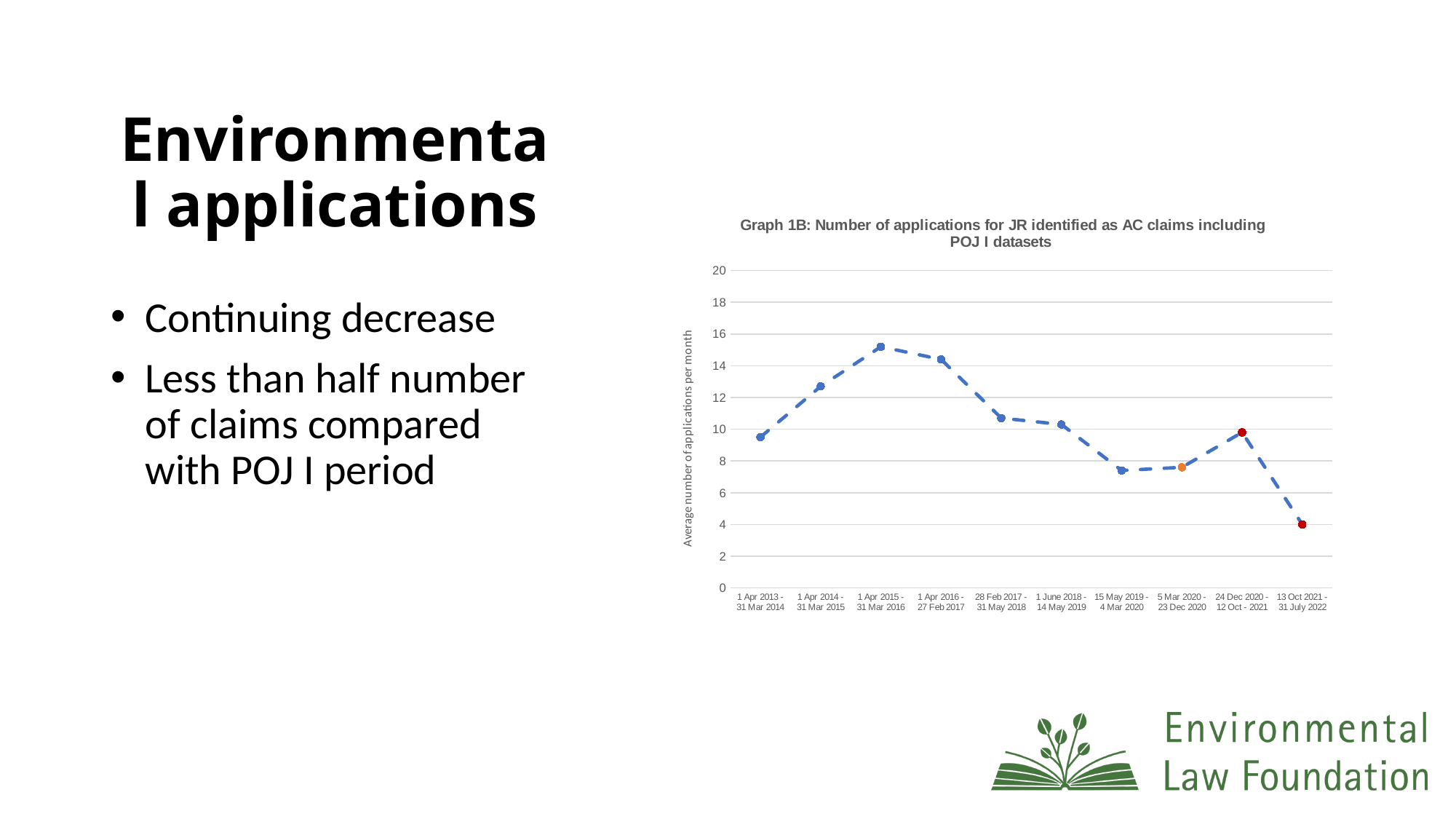
Is the value for 13 Oct 2021 - 31 July 2022 greater or less than 6? less Is the value for 15 May 2019 - 4 Mar 2020 greater or less than 8? less What kind of chart is shown on the slide? line chart Which period has the highest average number of applications per month? 1 Apr 2015 - 31 Mar 2016 Is the value for 1 Apr 2013 - 31 Mar 2014 greater or less than 8? greater What is the title of the chart? Graph 1B: Number of applications for JR identified as AC claims including POJ I datasets Which period has the lowest average number of applications per month? 13 Oct 2021 - 31 July 2022 Which is larger, the value for 1 Apr 2014 - 31 Mar 2015 or the value for 28 Feb 2017 - 31 May 2018? 1 Apr 2014 - 31 Mar 2015 Do the values rise or fall from 1 Apr 2015 - 31 Mar 2016 to 15 May 2019 - 4 Mar 2020? fall What is the label on the vertical axis of the chart? Average number of applications per month How many periods are plotted along the x axis of the chart? 10